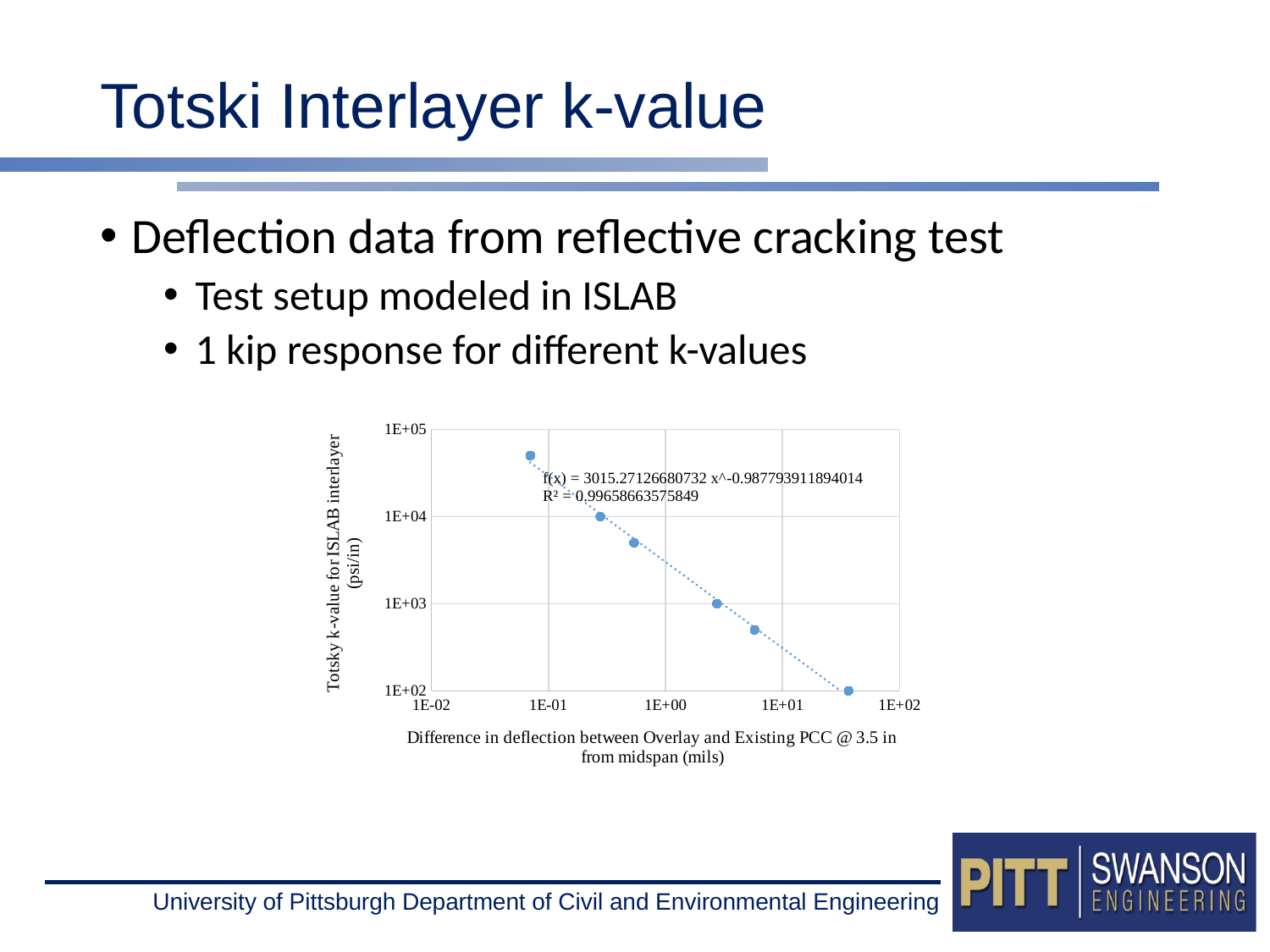
Which data point has the highest Totsky k-value, the leftmost or the rightmost? The leftmost What is the Totsky k-value of the rightmost data point on the chart? 1E+02 What R² value is shown for the trendline on the chart? R² = 0.99658663575849 Is the Totsky k-value of the rightmost data point greater or less than 1E+03? less Do the plotted k-values rise or fall as the deflection difference increases along the x axis? Fall Is the Totsky k-value of the leftmost data point greater or less than 1E+04? greater How many data points are plotted on the chart? 6 What is the highest value shown on the x axis of the chart? 1E+02 What kind of chart is shown on the slide? Scatter chart What is the y-axis title of the chart? Totsky k-value for ISLAB interlayer (psi/in) What is the lowest value shown on the y axis of the chart? 1E+02